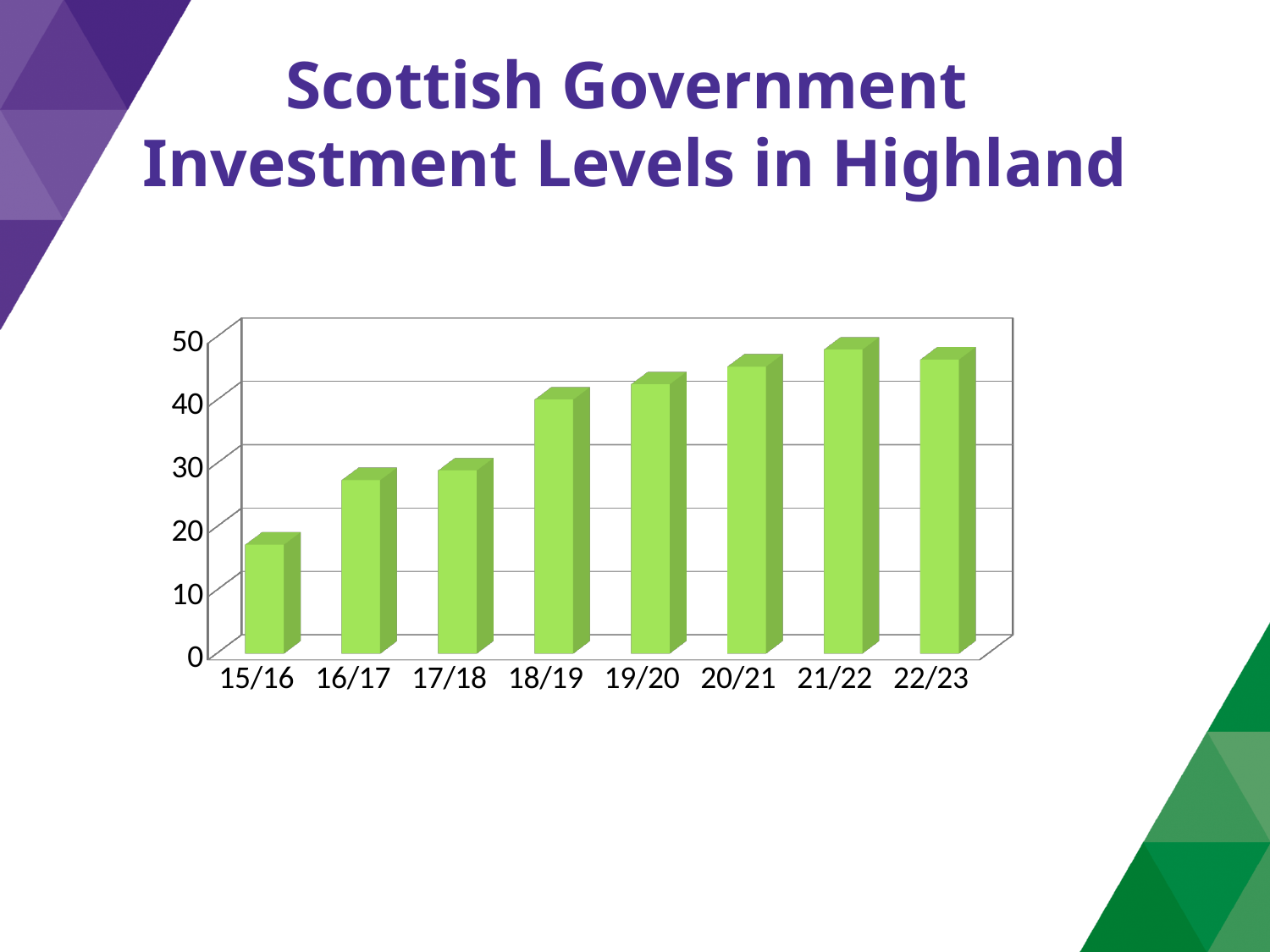
Is the value for 19/20 greater or less than 40? greater Is the value for 16/17 greater or less than 20? greater Is the value for 15/16 greater or less than 20? less How many years are shown on the x axis of the chart? 8 Which year has the lowest investment level? 15/16 What kind of chart is shown on the slide? bar chart Which is larger, the value for 17/18 or the value for 18/19? 18/19 Do the investment levels generally rise or fall from 15/16 to 22/23? rise Which is larger, the value for 15/16 or the value for 16/17? 16/17 What is the title of the slide containing the chart? Scottish Government Investment Levels in Highland